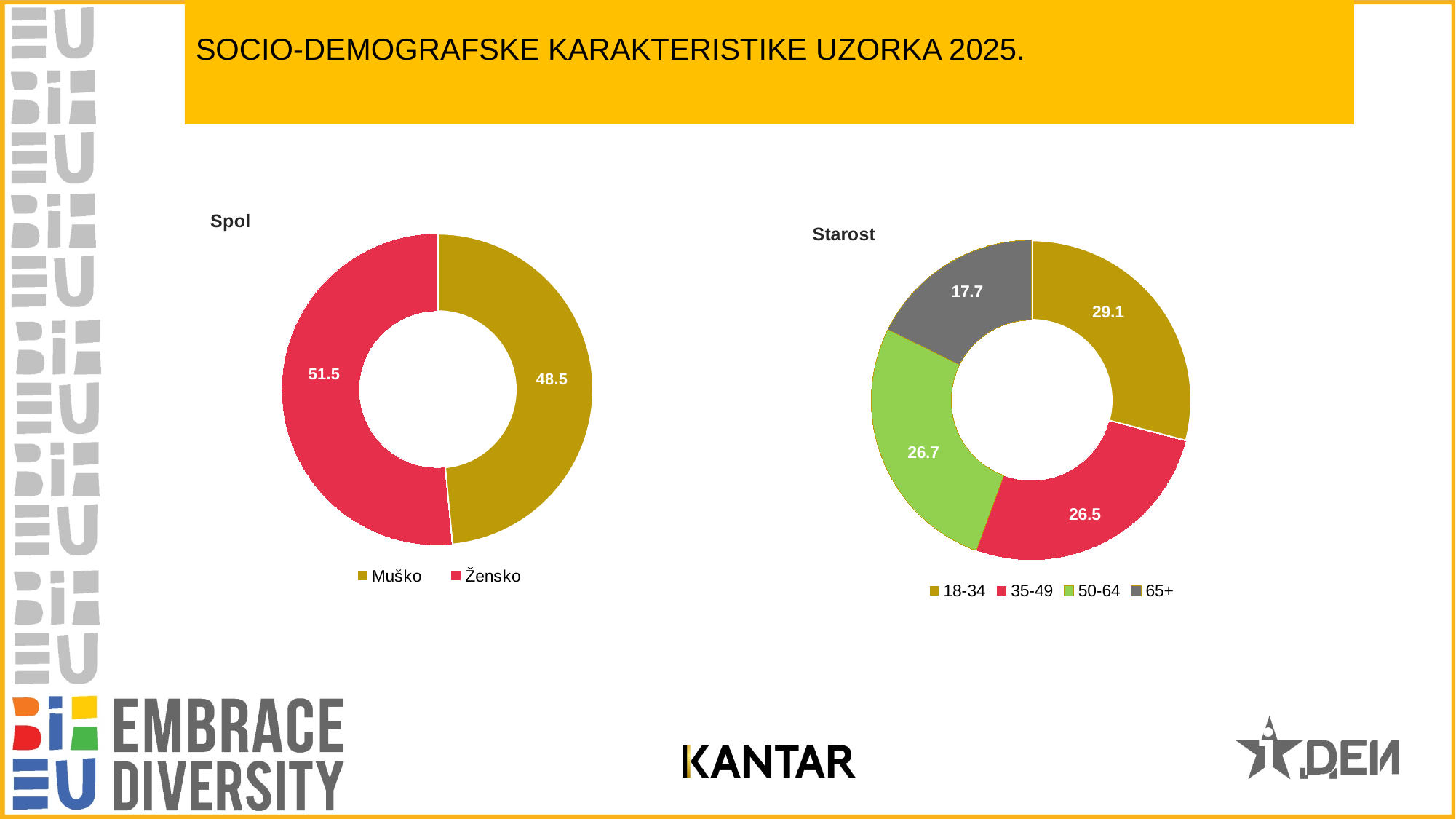
In the Spol chart, what is the value for Žensko? 51.5 In the Starost chart, what is the value for the 18-34 group? 29.1 In the Starost chart, what is the difference between the 18-34 and 65+ values? 11.4 In the Starost chart, which colour represents the 50-64 group? Green In the Starost chart, which age group has the highest value? 18-34 How many age groups are shown in the Starost chart? 4 In the Spol chart, which category has the larger value, Muško or Žensko? Žensko In the Spol chart, what is the difference between the Žensko and Muško values? 3 What kind of chart is the Spol chart? Doughnut (pie) chart In the Spol chart, what is the value for Muško? 48.5 In the Starost chart, what is the value for the 65+ group? 17.7 In the Starost chart, which age group has the lowest value? 65+